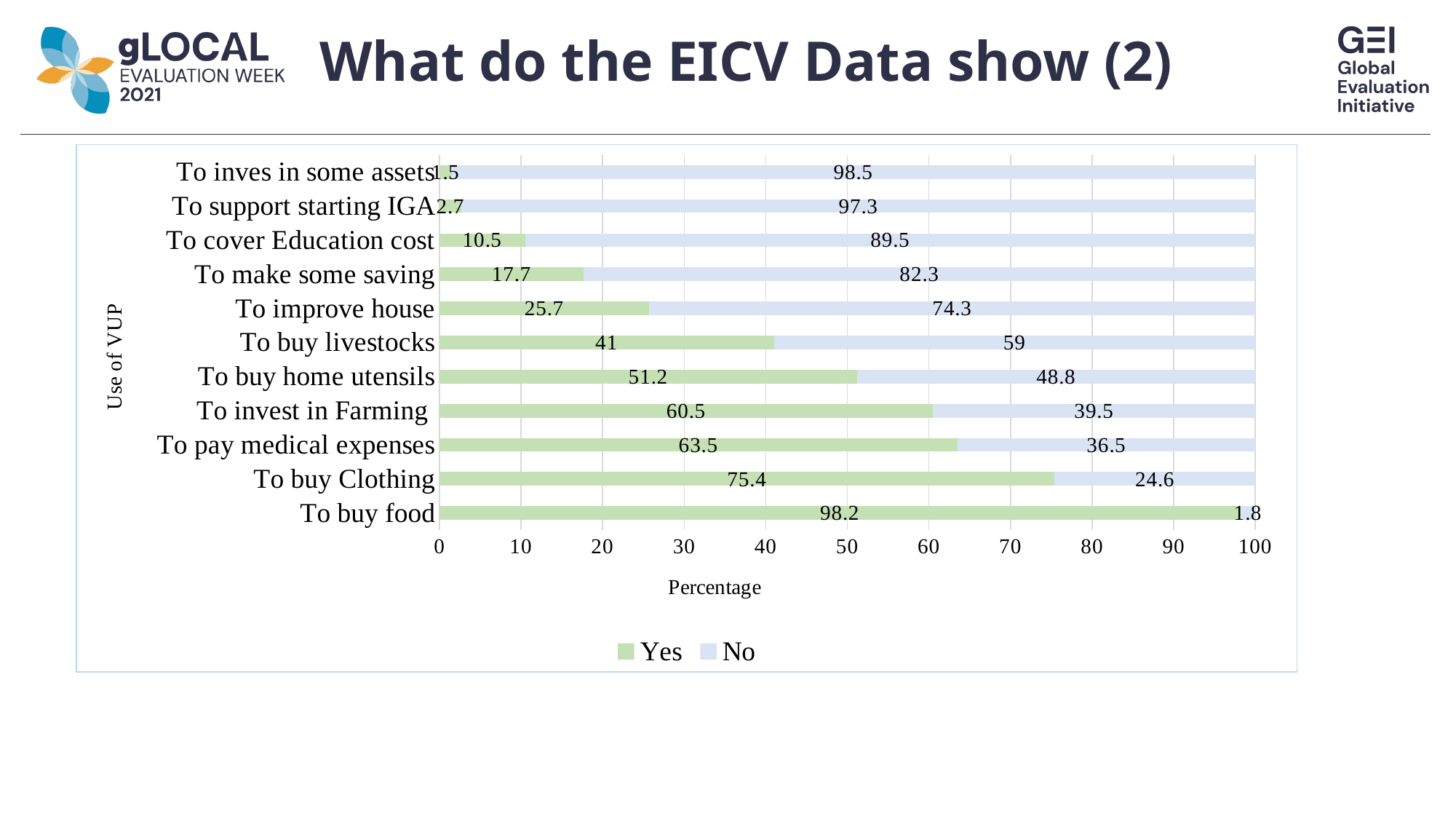
What is the total of the stacked bar for 'To improve house'? 100 Which category has the lowest 'Yes' value? To inves in some assets What is the difference between the 'Yes' values for 'To buy Clothing' and 'To pay medical expenses'? 11.9 Which category has the highest 'Yes' value? To buy food What kind of chart is shown on the slide? Stacked bar chart What is the 'Yes' value for 'To buy food'? 98.2 What is the 'No' value for 'To cover Education cost'? 89.5 How many categories are shown on the y axis? 11 How many series does the legend list? 2 What is the 'Yes' value for 'To buy livestocks'? 41 What is the label of the x axis? Percentage Which is larger: the 'Yes' value for 'To invest in Farming' or the 'Yes' value for 'To buy home utensils'? To invest in Farming